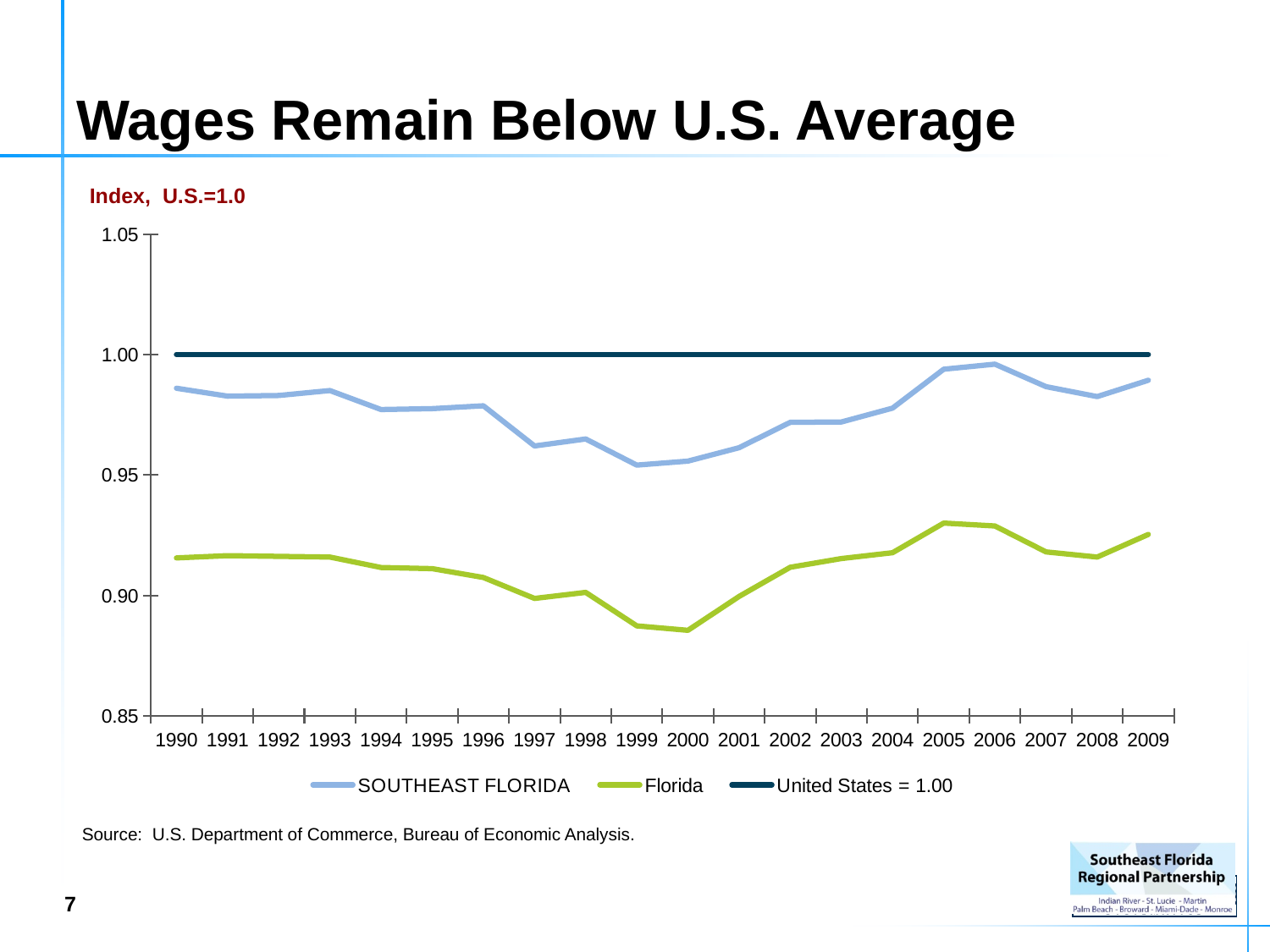
Is the value for SOUTHEAST FLORIDA in 2005 greater or less than 1.00? less Is the value for Florida in 1990 greater or less than 0.90? greater What is the value of the United States series in 2005? 1.00 What kind of chart is shown on the slide? line chart Does the Florida series rise or fall between 2000 and 2005? rise In 2009, which series has the higher value, SOUTHEAST FLORIDA or Florida? SOUTHEAST FLORIDA Does the SOUTHEAST FLORIDA series rise or fall between 1996 and 1999? fall How many years are shown along the x axis? 20 What is the title of the chart on the slide? Wages Remain Below U.S. Average Is the value for SOUTHEAST FLORIDA in 1990 greater or less than 0.95? greater How many series does the legend list? 3